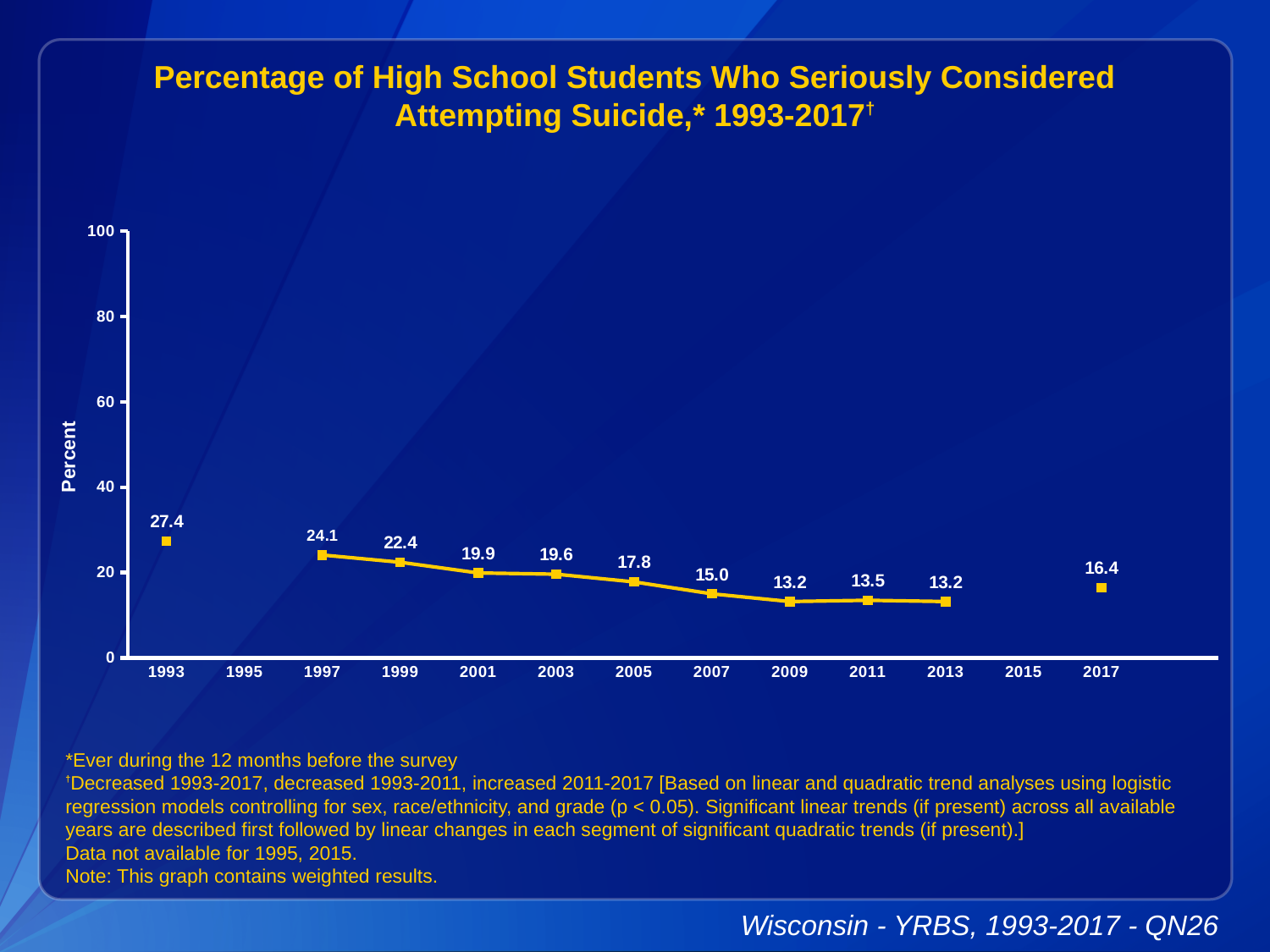
What kind of chart is shown on the slide? line chart What is the lowest value shown on the chart? 13.2 What is the difference between the 1997 value and the 1999 value? 1.7 Which is larger, the value for 2011 or the value for 2017? 2017 Do the values rise or fall from 1993 to 2011? fall What is the value plotted for 2007? 15.0 What percentage of high school students seriously considered attempting suicide in 1993? 27.4 Which year has the highest percentage on the chart? 1993 How many years have a data point plotted on the chart? 11 What is the value plotted for 2017? 16.4 Is the value for 2005 greater or less than 20? less What is the difference between the 1993 value and the 2017 value? 11.0